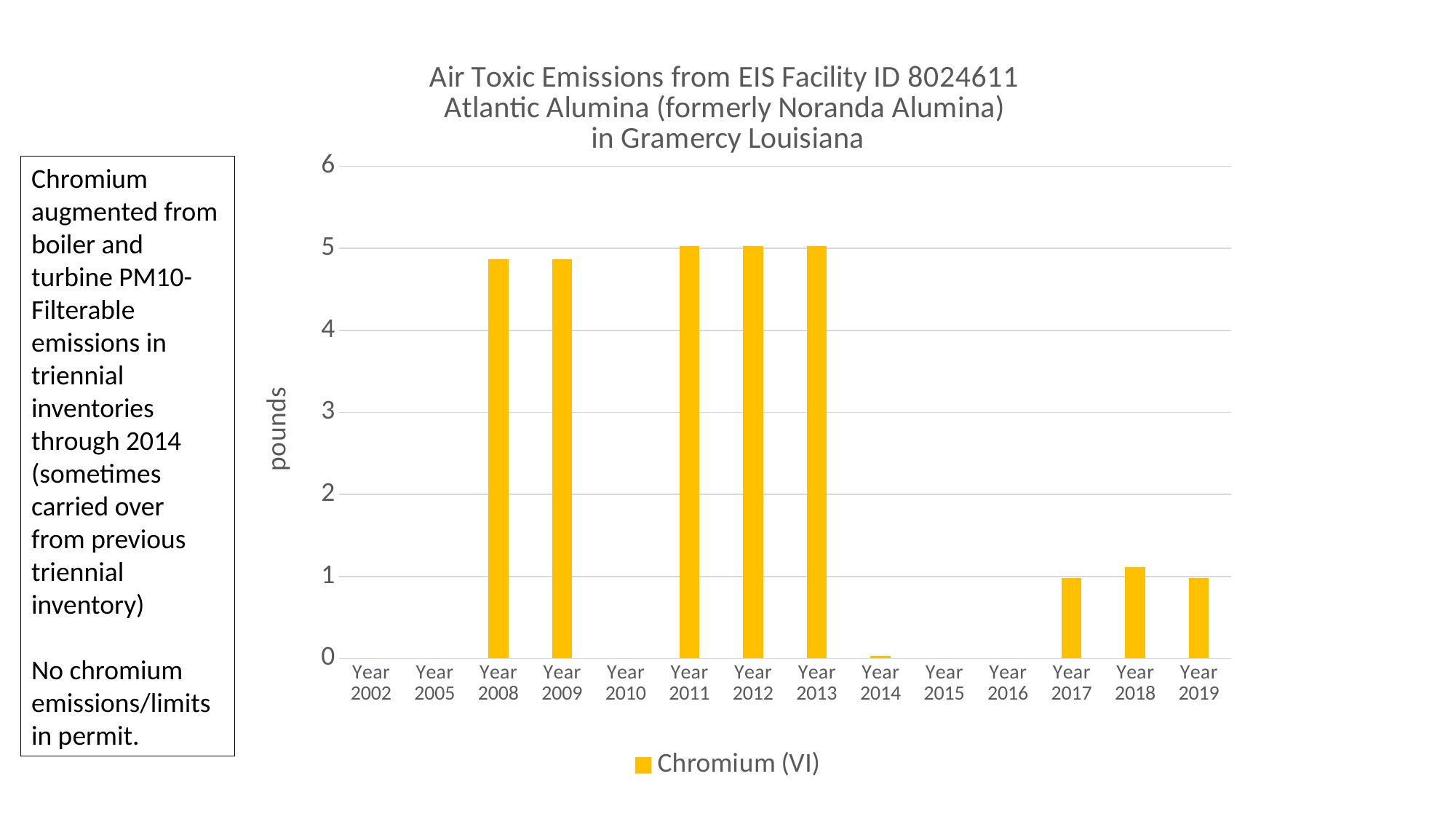
Is the value for Year 2018 greater or less than 1? greater What kind of chart is shown on the slide? bar chart What is the label on the y axis? pounds Which is larger, the value for Year 2011 or the value for Year 2019? Year 2011 How many year categories are shown on the x axis? 14 Which is larger, the value for Year 2014 or the value for Year 2018? Year 2018 How many series does the legend list? 1 Is the value for Year 2008 greater or less than 4? greater Is the value for Year 2009 greater or less than 5? less What series name is shown in the legend? Chromium (VI)